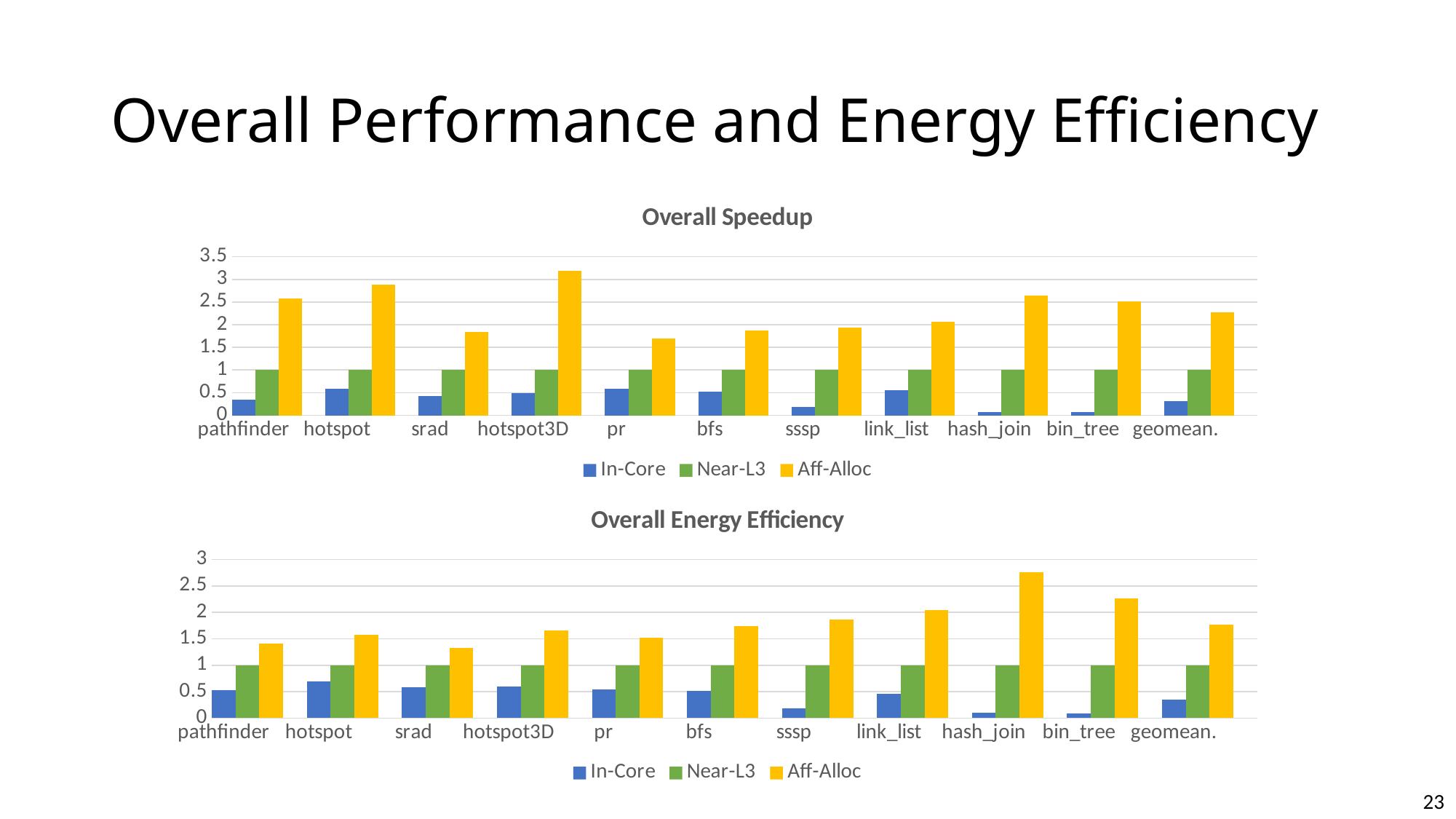
In the Overall Energy Efficiency chart, is the Aff-Alloc value for hash_join greater or less than 2.5? greater In the Overall Speedup chart, which category has the highest Aff-Alloc value? hotspot3D How many categories are shown on the x axis of the Overall Speedup chart? 11 In the Overall Energy Efficiency chart, which category has the highest In-Core value? hotspot In the Overall Speedup chart, is the Aff-Alloc value for hotspot3D greater or less than 3? greater In the Overall Speedup chart, which category has the lowest Aff-Alloc value? pr In the Overall Speedup chart, which is larger, the Aff-Alloc value for hotspot or for srad? hotspot In the Overall Energy Efficiency chart, which is larger, the Aff-Alloc value for bin_tree or for pathfinder? bin_tree In the Overall Energy Efficiency chart, which category has the highest Aff-Alloc value? hash_join How many series does the legend of the Overall Energy Efficiency chart list? 3 What type of chart is the Overall Speedup chart? bar chart In the Overall Speedup chart, what is the Near-L3 value for pathfinder? 1